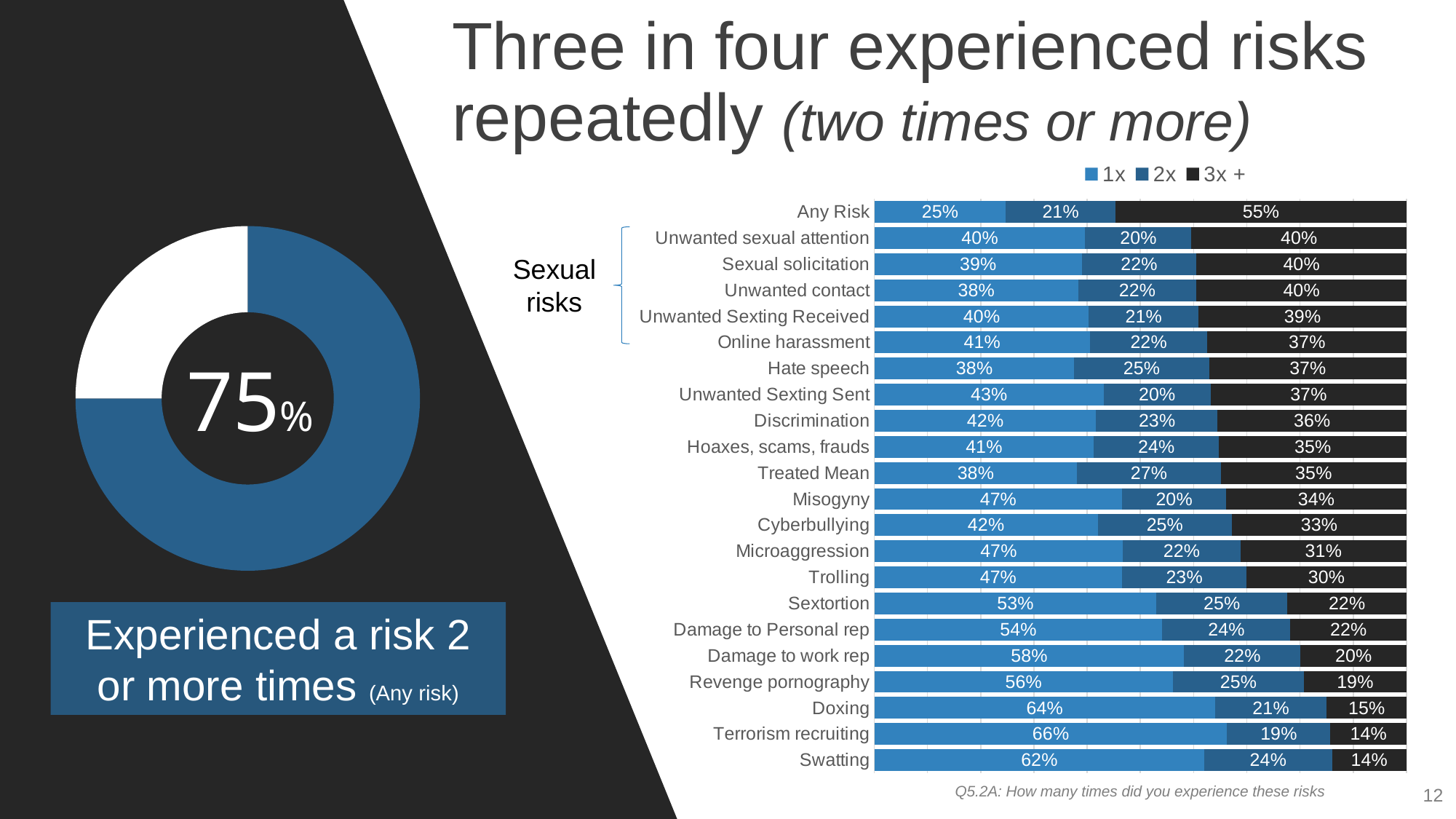
In the bar chart on the right, which category has the lowest 1x value? Any Risk In the bar chart on the right, what is the 1x value for Doxing? 64% In the bar chart on the right, what is the 3x + value for Any Risk? 55% What kind of chart is the chart on the left side of the slide showing 75%? doughnut chart In the bar chart on the right, how many series does the legend list? 3 In the bar chart on the right, which category has the highest 3x + value? Any Risk In the bar chart on the right, what is the 2x value for Treated Mean? 27% In the bar chart on the right, which is larger: the 1x value for Sextortion or the 1x value for Misogyny? Sextortion In the bar chart on the right, what is the difference between the 1x value and the 3x + value for Doxing? 49 percentage points What kind of chart is the chart on the right side of the slide? bar chart In the bar chart on the right, how many risk categories are plotted? 22 In the bar chart on the right, which category has the highest 1x value? Terrorism recruiting